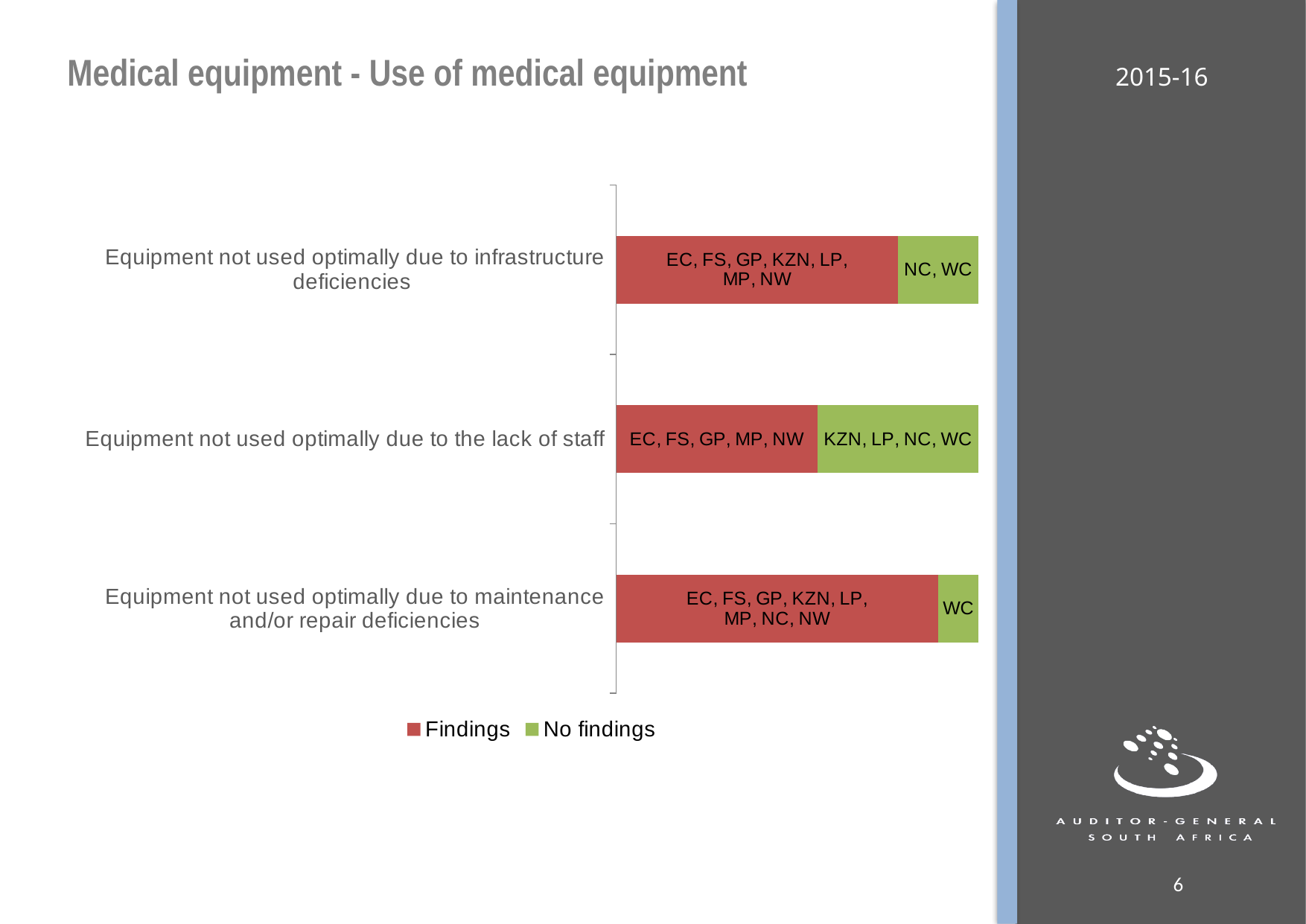
Which category has the largest 'Findings' segment? Equipment not used optimally due to maintenance and/or repair deficiencies Which provinces are listed in the 'Findings' segment for 'Equipment not used optimally due to the lack of staff'? EC, FS, GP, MP, NW Which provinces are listed in the 'No findings' segment for 'Equipment not used optimally due to infrastructure deficiencies'? NC, WC Which provinces are listed in the 'No findings' segment for 'Equipment not used optimally due to the lack of staff'? KZN, LP, NC, WC Which category has the largest 'No findings' segment? Equipment not used optimally due to the lack of staff What are the two series named in the legend? Findings, No findings How many categories are shown on the chart? 3 Which provinces are listed in the 'Findings' segment for 'Equipment not used optimally due to maintenance and/or repair deficiencies'? EC, FS, GP, KZN, LP, MP, NC, NW What kind of chart is shown on the slide? Stacked bar chart Which colour represents the 'Findings' series? Red How many series does the legend list? 2 Which province is listed in the 'No findings' segment for 'Equipment not used optimally due to maintenance and/or repair deficiencies'? WC